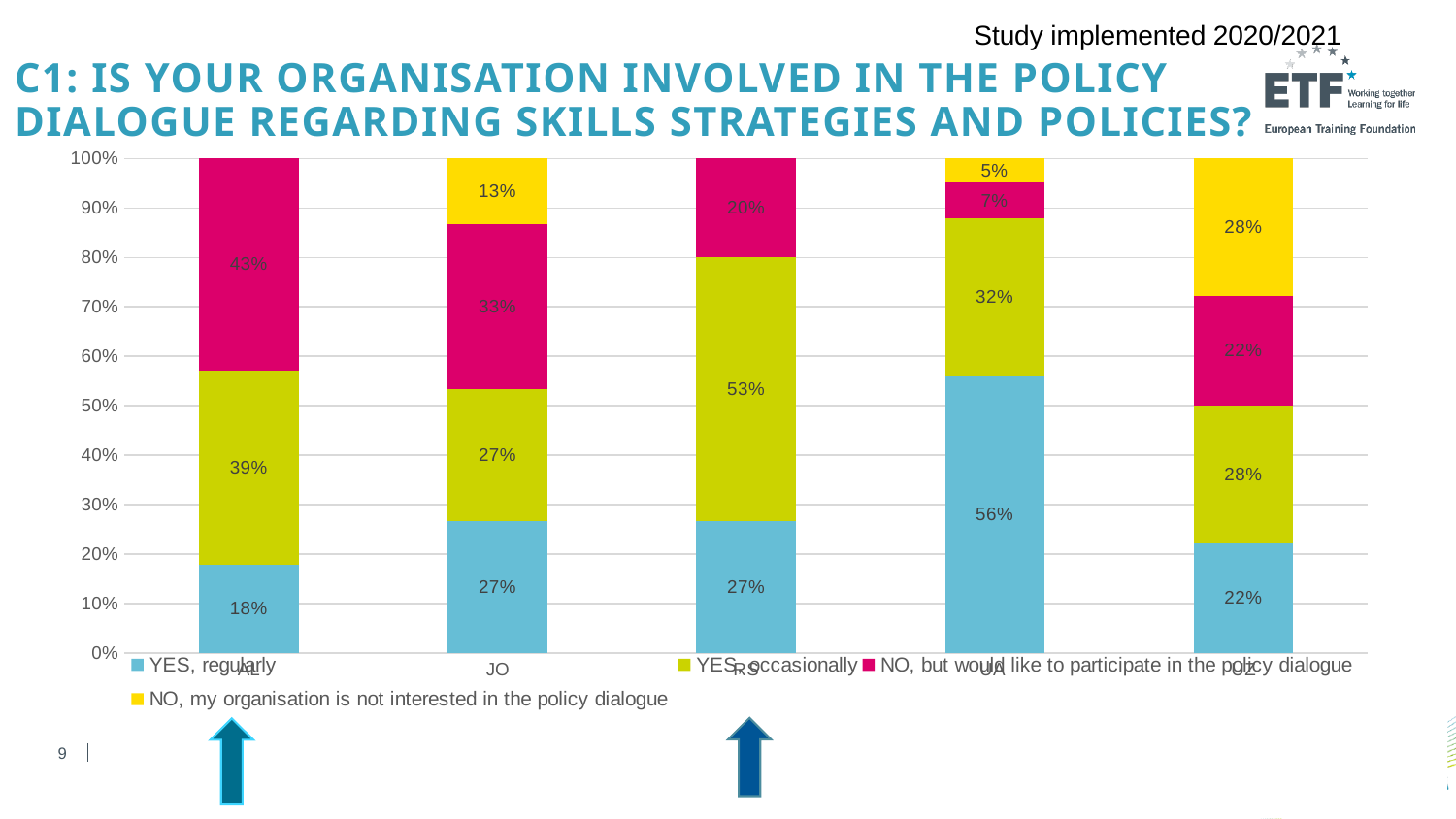
How many bars (countries) are plotted in the chart? 5 What kind of chart is shown on the slide? Stacked bar chart Which has a larger 'YES, occasionally' share: JO or the third bar from the left? The third bar from the left (53%) What colour represents the 'YES, regularly' series? Blue Which bar has the lowest 'YES, regularly' share? The first bar from the left (18%) How many series does the legend list? 4 Which bar has the highest 'YES, regularly' share? The fourth bar from the left (56%) What is the 'NO, but would like to participate in the policy dialogue' value for the third bar from the left? 20% What is the 'NO, my organisation is not interested in the policy dialogue' value for the rightmost bar? 28% What is the 'YES, regularly' value for the fourth bar from the left? 56% What is the 'YES, regularly' value for JO? 27% For JO, what is the difference between the 'NO, but would like to participate' value and the 'NO, my organisation is not interested' value? 20 percentage points